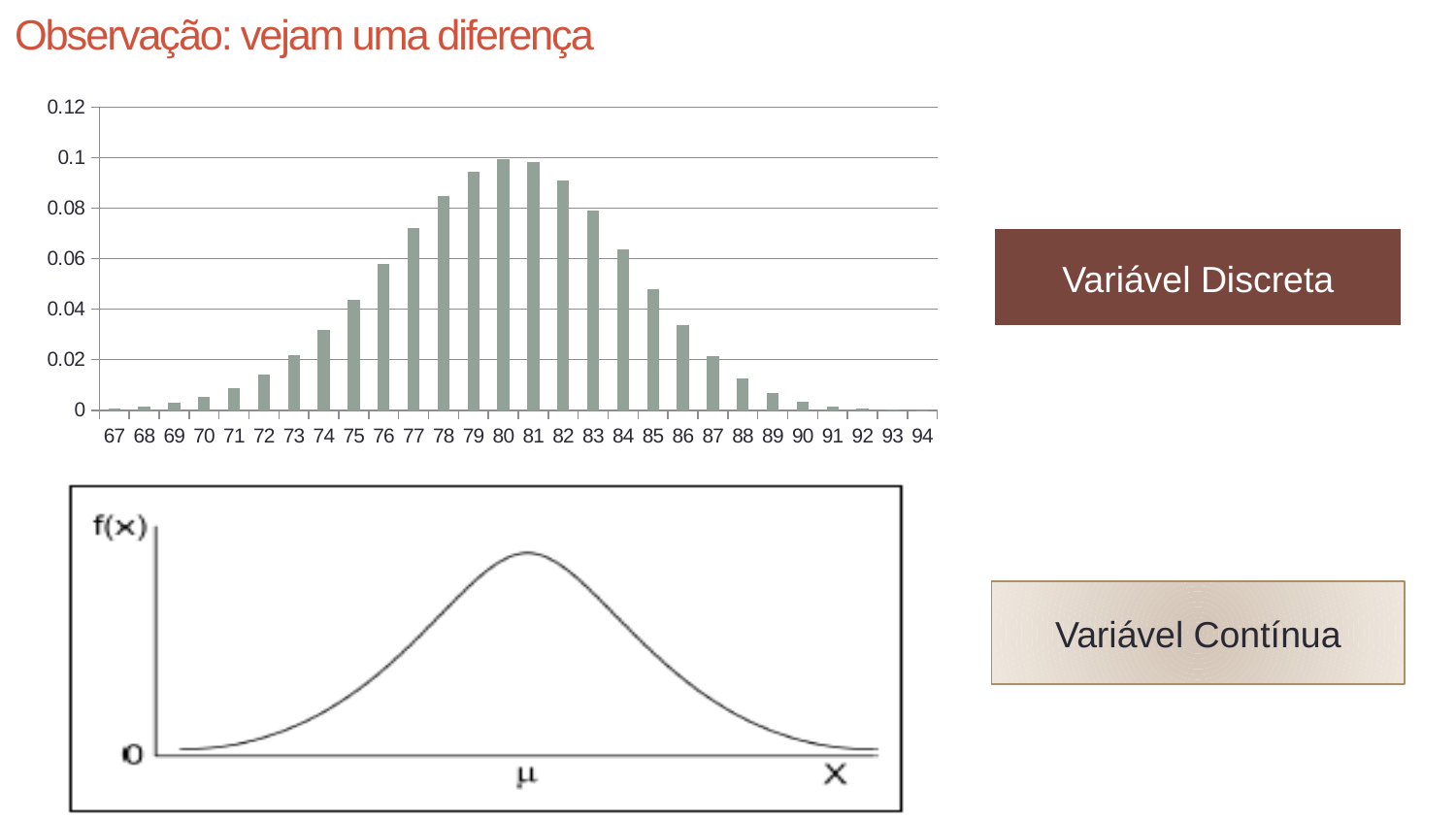
What label is shown in the box to the right of the top bar chart? Variável Discreta In the top bar chart, which has the larger value, 78 or 84? 78 In the top bar chart, is the value for 77 greater or less than 0.06? greater In the top bar chart, is the value for 80 greater or less than 0.08? greater In the top bar chart, is the value for 88 greater or less than 0.02? less In the top bar chart, do the values rise or fall from 67 to 80? rise In the top bar chart, which has the larger value, 76 or 86? 76 In the top bar chart, do the values rise or fall from 81 to 94? fall What kind of chart is the top chart on the slide? bar chart How many categories are shown on the x axis of the top bar chart? 28